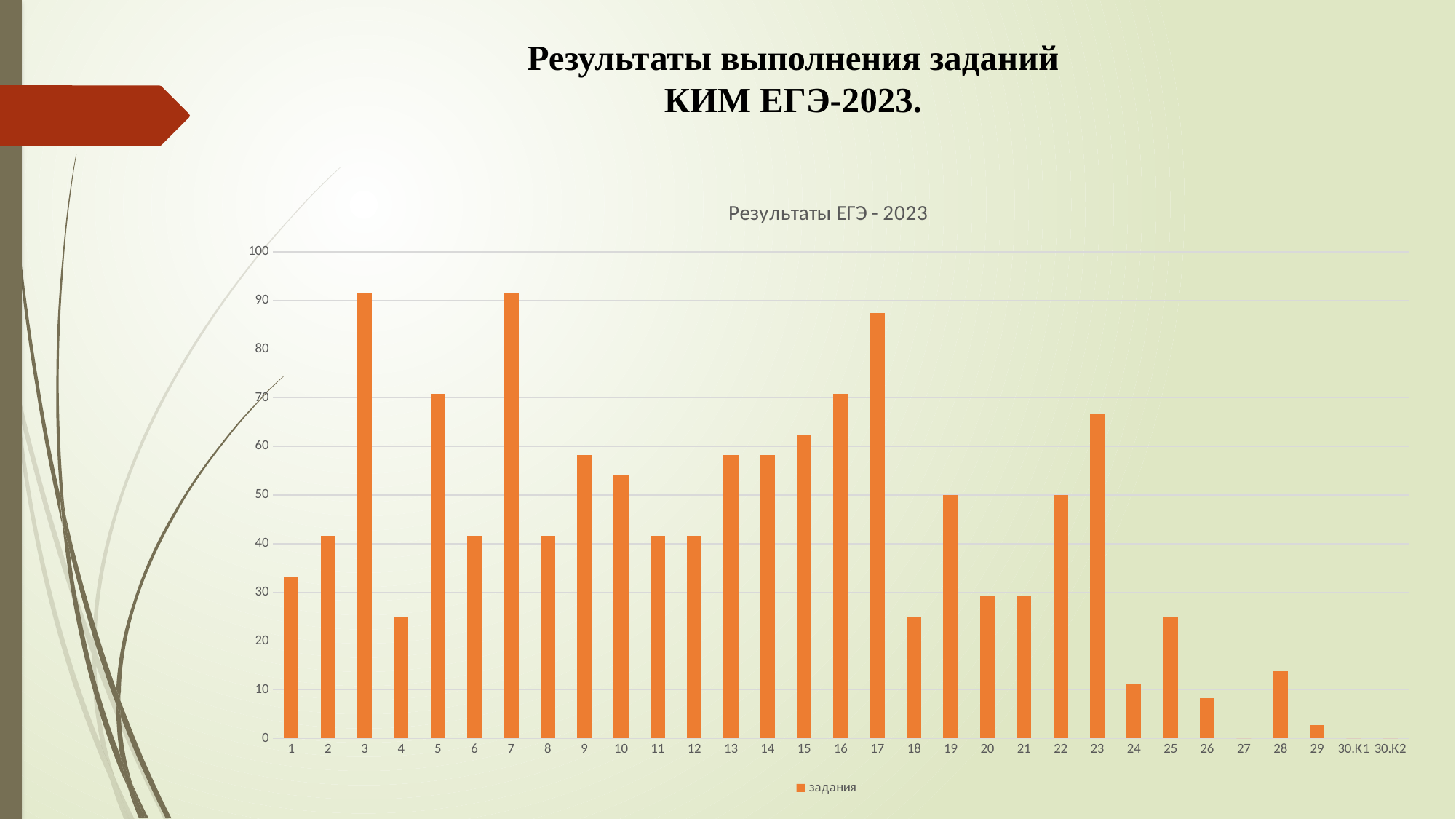
Is the value for category 4 greater or less than 30? less How many series does the legend list? 1 Is the value for category 17 greater or less than 80? greater Which has the larger value, category 16 or category 17? 17 Is the value for category 23 greater or less than 60? greater What is the title of the chart? Результаты ЕГЭ - 2023 What kind of chart is shown on the slide? bar chart Which has the larger value, category 9 or category 10? 9 How many categories are shown on the x axis? 31 What is the name of the series listed in the legend? задания